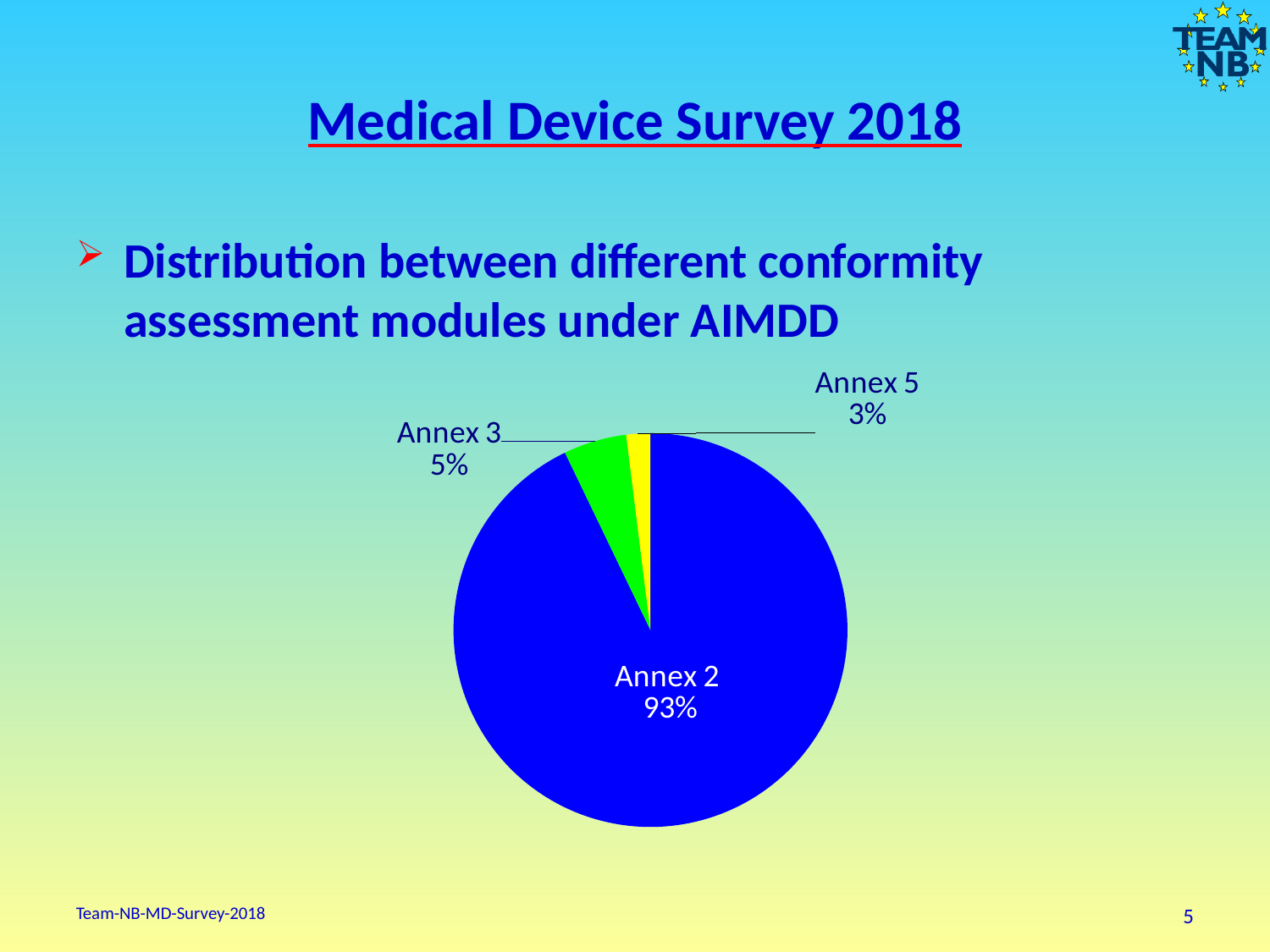
Which annex has the largest share of the pie? Annex 2 What colour is the Annex 3 slice? Green How many slices does the pie chart have? 3 What kind of chart is shown on the slide? Pie chart What colour is the Annex 2 slice? Blue Which has a larger share, Annex 3 or Annex 5? Annex 3 What is the difference in percentage points between Annex 3 and Annex 5? 2 What share of the pie does Annex 2 represent? 93% What share of the pie does Annex 5 represent? 3% Which annex has the smallest share of the pie? Annex 5 What share of the pie does Annex 3 represent? 5% What is the difference in percentage points between Annex 2 and Annex 3? 88